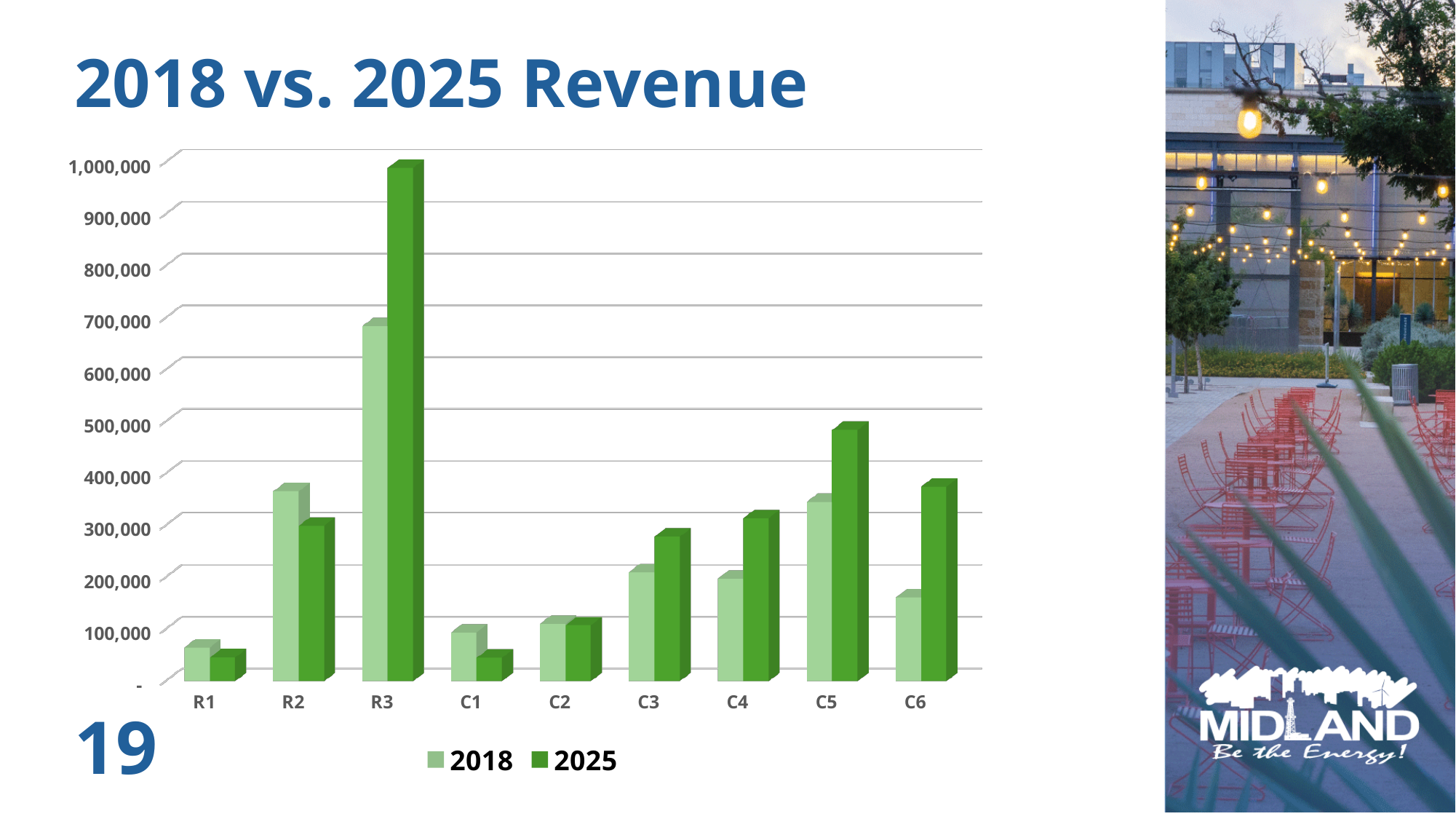
Which category has the highest 2025 revenue? R3 Which category has the highest 2018 revenue? R3 Is the 2025 value for R3 greater or less than 900,000? greater For R2, which year has the larger revenue, 2018 or 2025? 2018 Which category has the lowest 2018 revenue? R1 How many series does the legend list? 2 Is the 2018 value for C1 greater or less than 100,000? less What kind of chart is shown on the slide? bar chart Is the 2025 value for C5 greater or less than 500,000? less What is the title of the chart? 2018 vs. 2025 Revenue For R3, which year has the larger revenue, 2018 or 2025? 2025 How many categories are shown on the x axis? 9